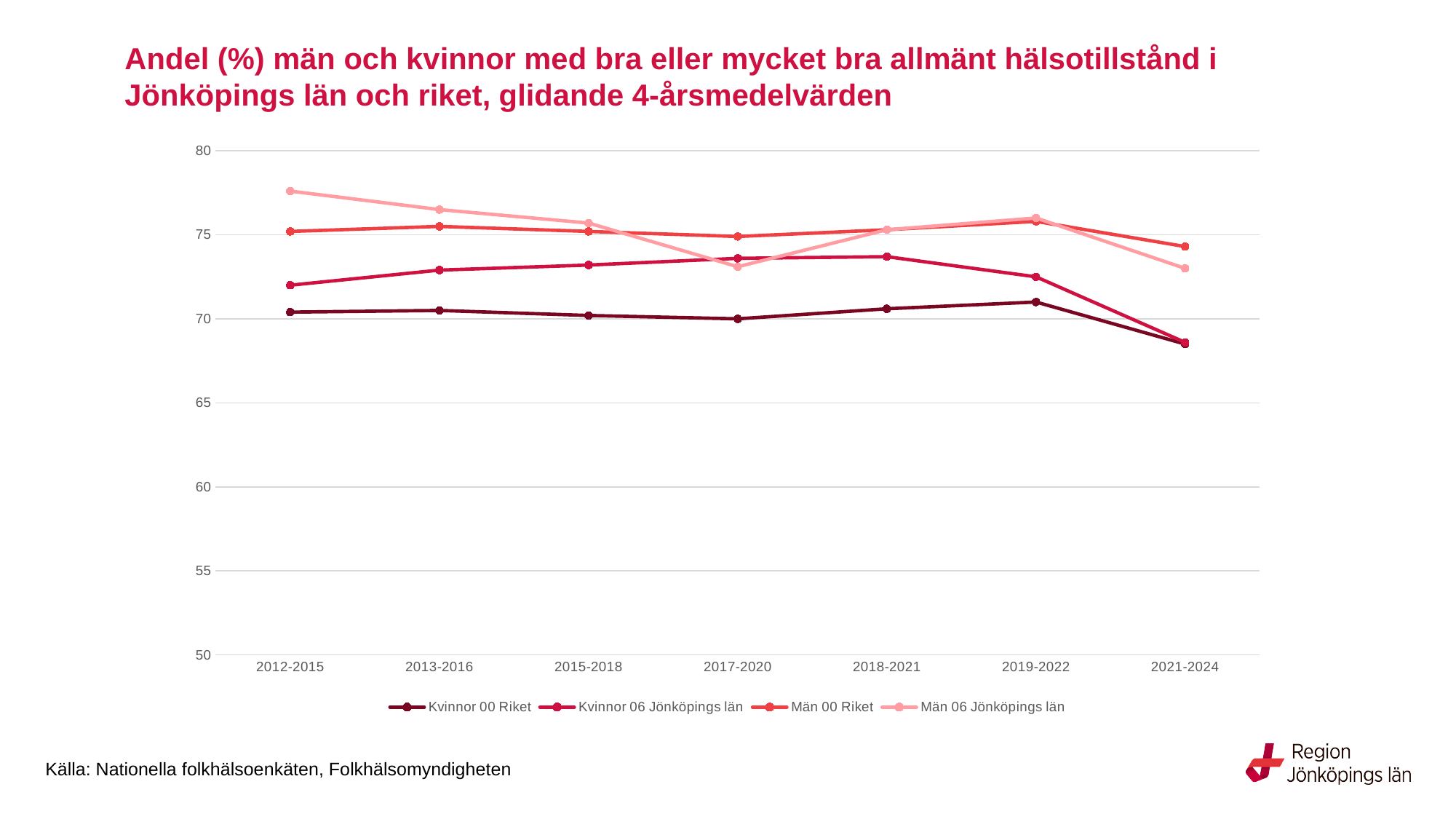
Is the value for Män 06 Jönköpings län in 2012-2015 greater or less than 75? greater Does the value for Kvinnor 06 Jönköpings län rise or fall from 2019-2022 to 2021-2024? Fall Which is higher in 2017-2020, Män 00 Riket or Män 06 Jönköpings län? Män 00 Riket Is the value for Män 00 Riket in 2021-2024 greater or less than 75? less How many periods are shown on the x axis? 7 Which series has the lowest value in 2012-2015? Kvinnor 00 Riket What kind of chart is shown on the slide? Line chart How many series does the legend list? 4 Is the value for Kvinnor 00 Riket in 2021-2024 greater or less than 70? less What is the source cited below the chart? Nationella folkhälsoenkäten, Folkhälsomyndigheten Which series has the highest value in 2012-2015? Män 06 Jönköpings län In which period does Män 06 Jönköpings län reach its highest value? 2012-2015